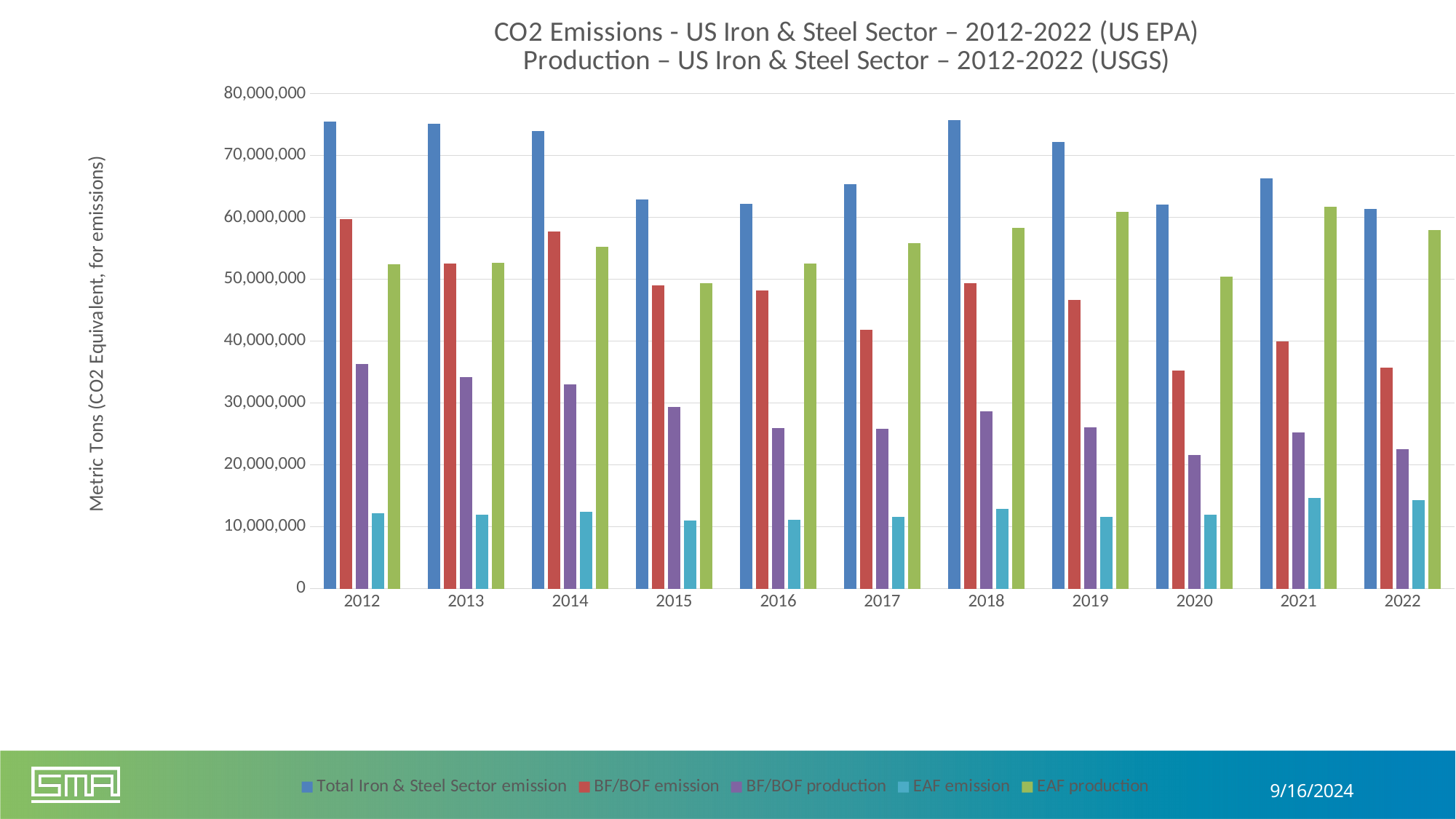
Is the value for BF/BOF emission in 2017 greater or less than 50,000,000? less In 2022, which is larger: BF/BOF emission or EAF production? EAF production Which year has the highest BF/BOF emission? 2012 How many years are shown along the x axis? 11 Is the value for BF/BOF production in 2012 greater or less than 30,000,000? greater How many series does the legend list? 5 What kind of chart is shown on the slide? Bar chart Is the value for BF/BOF emission in 2022 greater or less than 40,000,000? less Does BF/BOF emission generally rise or fall from 2012 to 2022? Fall What is the label on the vertical axis? Metric Tons (CO2 Equivalent, for emissions)